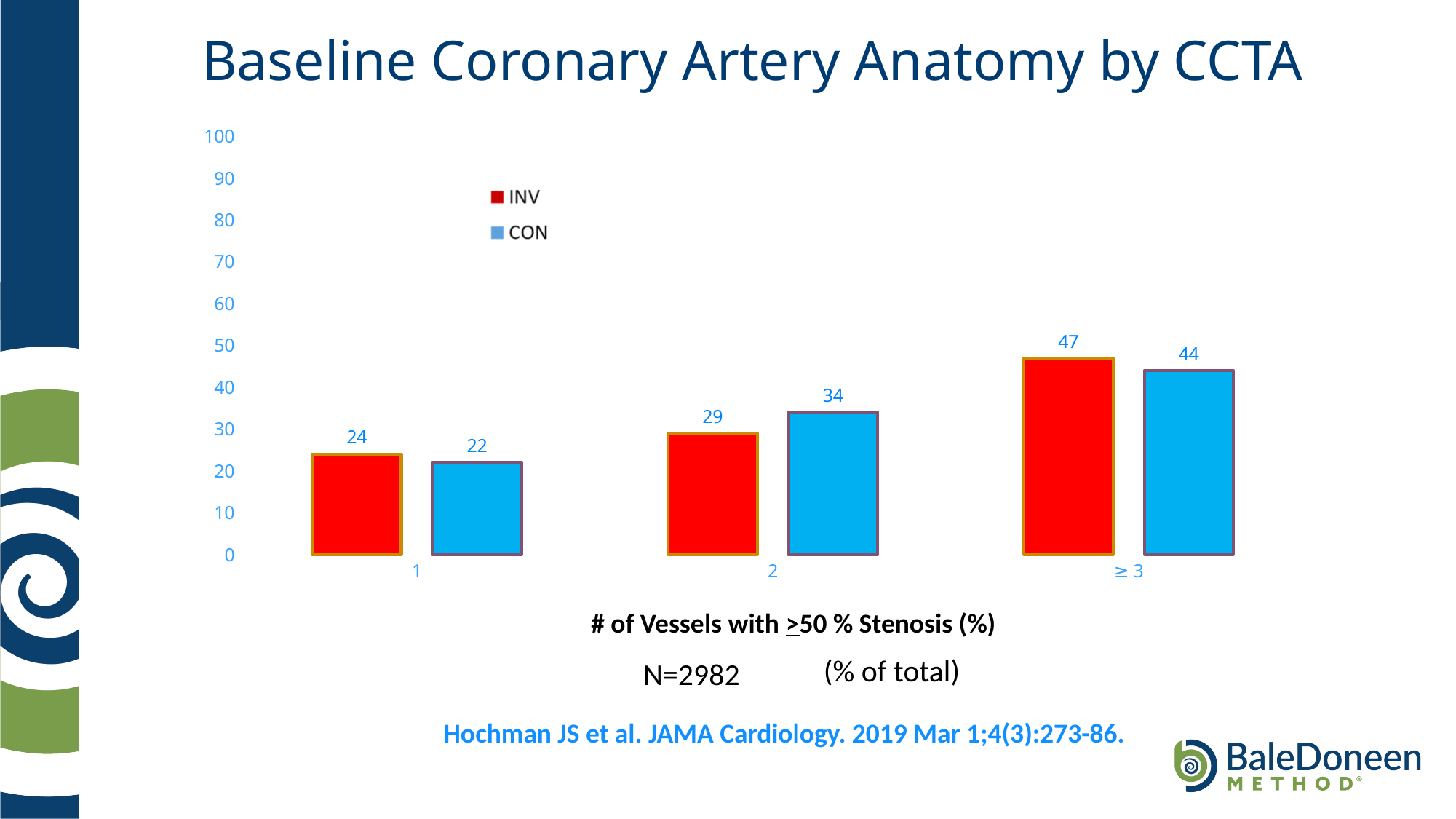
Which category has the highest INV value? ≥ 3 Which category has the lowest CON value? 1 What is the INV value for the category ≥ 3? 47 What is the CON value for the category 1? 22 What is the CON value for the category 2? 34 Do the INV values rise or fall as the number of vessels increases along the x axis? Rise What kind of chart is shown on the slide? Bar chart What is the difference between the INV and CON values for the category 2? 5 For the category ≥ 3, which series has the larger value, INV or CON? INV How many series does the legend list? 2 What is the INV value for the category 1 (number of vessels with ≥50% stenosis)? 24 How many categories are shown on the x axis? 3